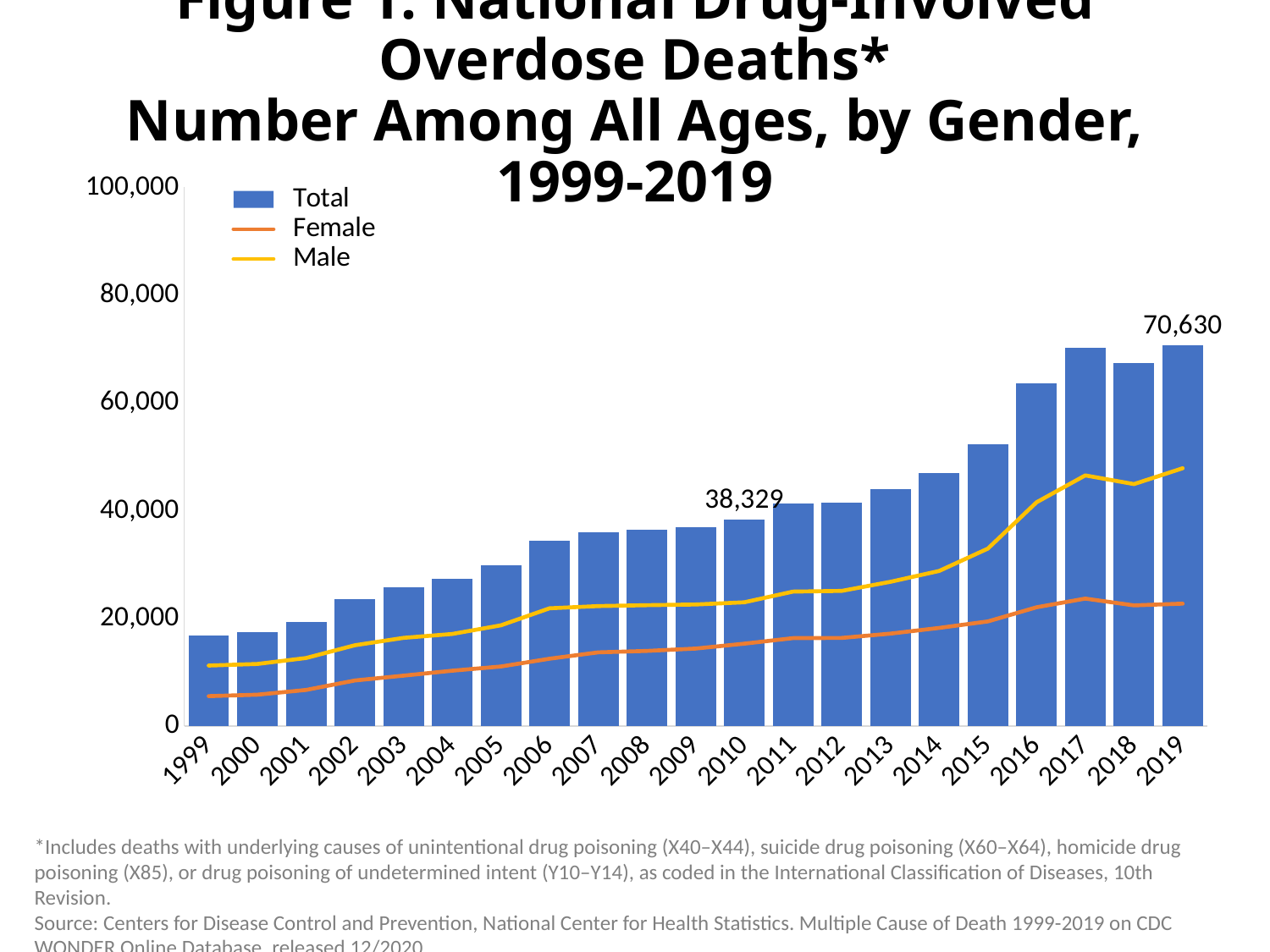
How many series does the legend list? 3 What is the Total number of drug-involved overdose deaths shown for 2019? 70,630 What is the difference between the Total values labelled for 2019 and 2010? 32,301 What kind of chart is this? bar chart with line series Does the Total series generally rise or fall from 1999 to 2019? rise Is the Male value for 2019 greater or less than 40,000? greater Is the Total value for 2016 greater or less than 60,000? greater Which is larger, the Total for 2016 or the Total for 2015? 2016 In 2019, which line is higher, Male or Female? Male Is the Total value for 2015 greater or less than 60,000? less What is the Total number of drug-involved overdose deaths shown for 2010? 38,329 How many years are shown on the x axis? 21